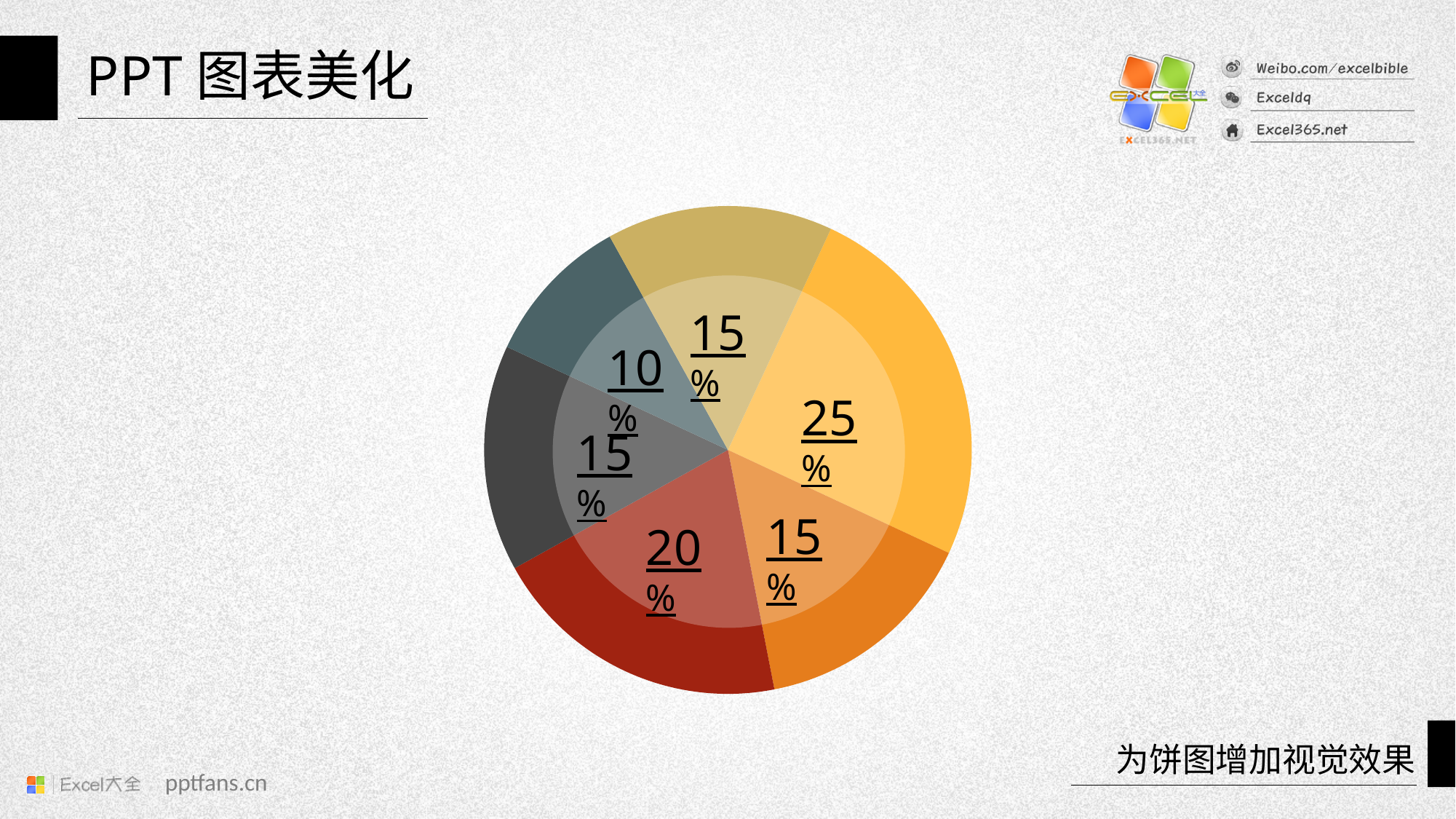
What kind of chart is shown on the slide? pie chart Which is larger in the pie chart, the red slice or the orange slice? the red slice What percentage is shown on the blue-gray slice of the pie chart? 10% How many slices in the pie chart are labelled 15%? 3 What percentage is shown on the red slice of the pie chart? 20% What is the difference between the yellow slice and the red slice in the pie chart? 5% Which slice of the pie chart has the largest share? the yellow slice (25%) What is the combined share of the yellow and red slices in the pie chart? 45% What percentage is shown on the yellow slice of the pie chart? 25% Which slice of the pie chart has the smallest share? the blue-gray slice (10%) What percentage is shown on the orange slice of the pie chart? 15% How many slices does the pie chart have? 6